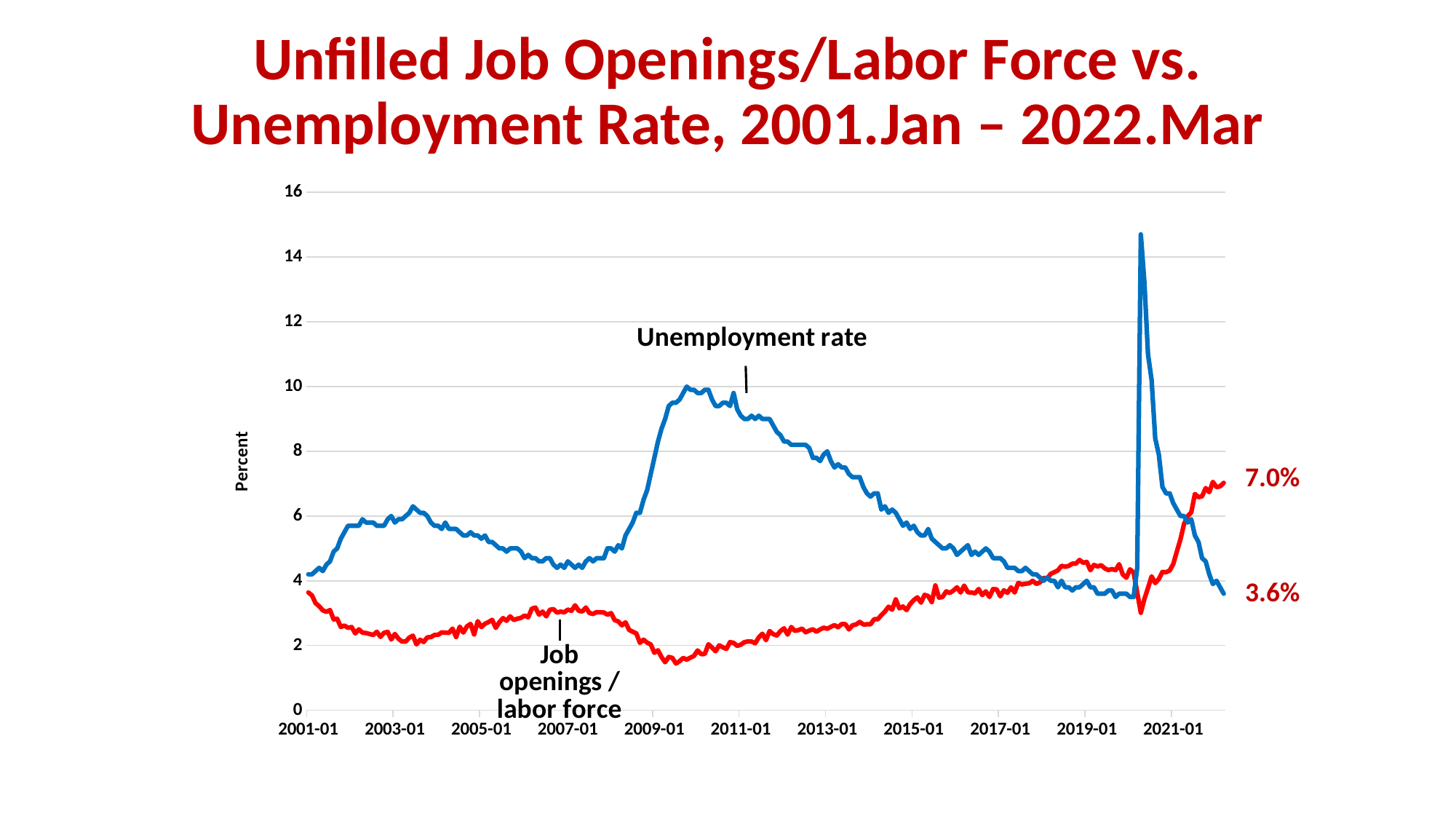
What is the label on the vertical axis of the chart? Percent Is the peak of the Unemployment rate line in 2020 greater or less than 14? greater Is the Unemployment rate around 2010-01 greater or less than 8? greater What is the final labelled value of the Unemployment rate line? 3.6% What is the final labelled value of the Job openings / labor force line? 7.0% Which series reaches the highest value anywhere on the chart? Unemployment rate How many data series are plotted on the chart? 2 At the end of the period, which series is higher: Unemployment rate or Job openings / labor force? Job openings / labor force Does the Unemployment rate line rise or fall between 2011-01 and 2019-01? Fall What type of chart is shown on the slide? Line chart What is the difference between the final labelled values of the Job openings / labor force line (7.0%) and the Unemployment rate line (3.6%)? 3.4 percentage points Is the lowest point of the Job openings / labor force line greater or less than 2? less